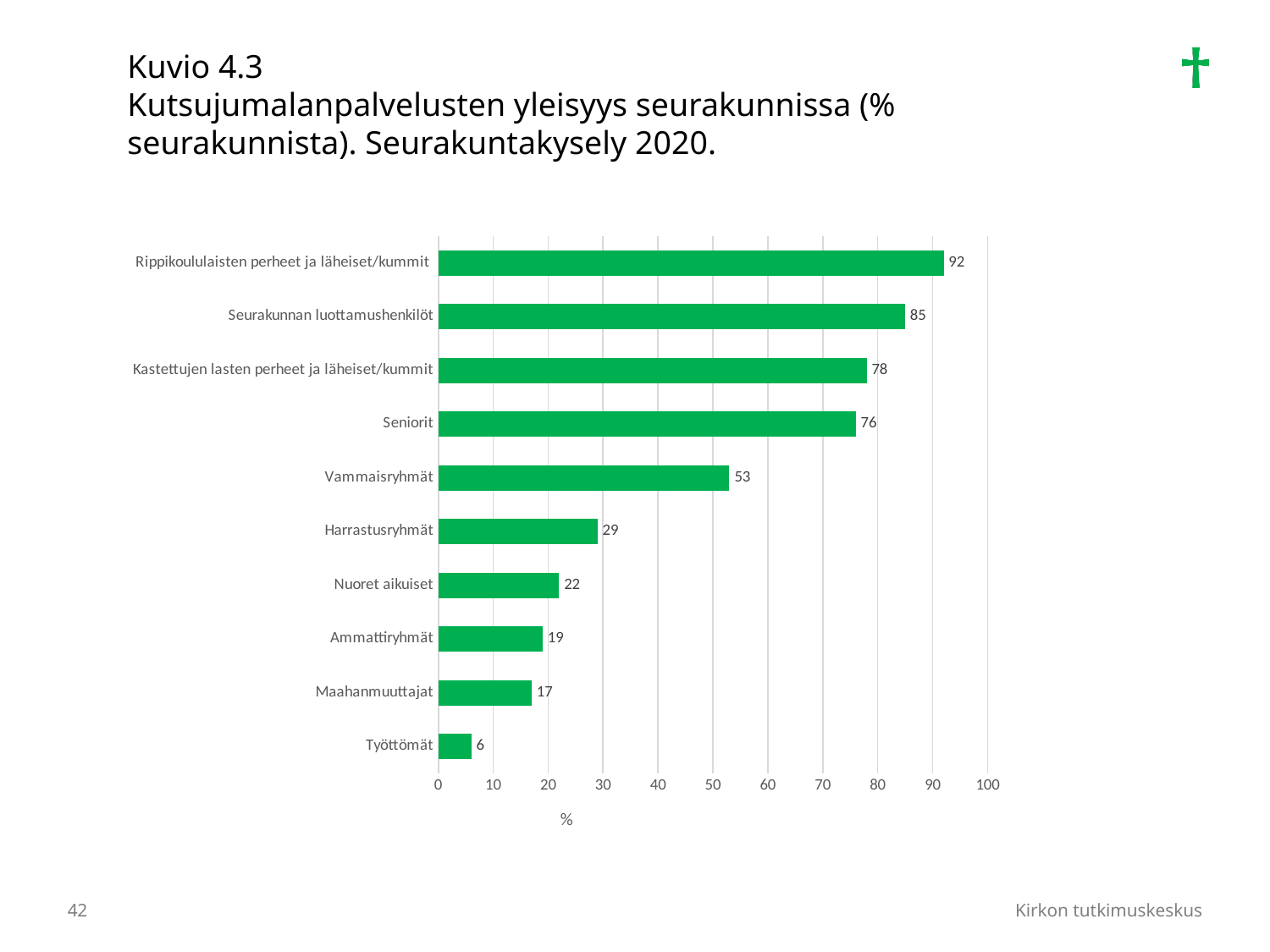
Which category has the lowest value? Työttömät What is the value for Vammaisryhmät? 53 Which category has the highest value? Rippikoululaisten perheet ja läheiset/kummit What is the difference between the highest and lowest values in the chart? 86 What is the value for Maahanmuuttajat? 17 What kind of chart is shown on the slide? bar chart What unit is shown on the horizontal axis label? % What is the difference between the values for Seurakunnan luottamushenkilöt and Kastettujen lasten perheet ja läheiset/kummit? 7 Is the value for Ammattiryhmät greater or less than 20? less Which is larger, the value for Harrastusryhmät or the value for Nuoret aikuiset? Harrastusryhmät How many categories are shown in the chart? 10 What is the value for Seniorit? 76